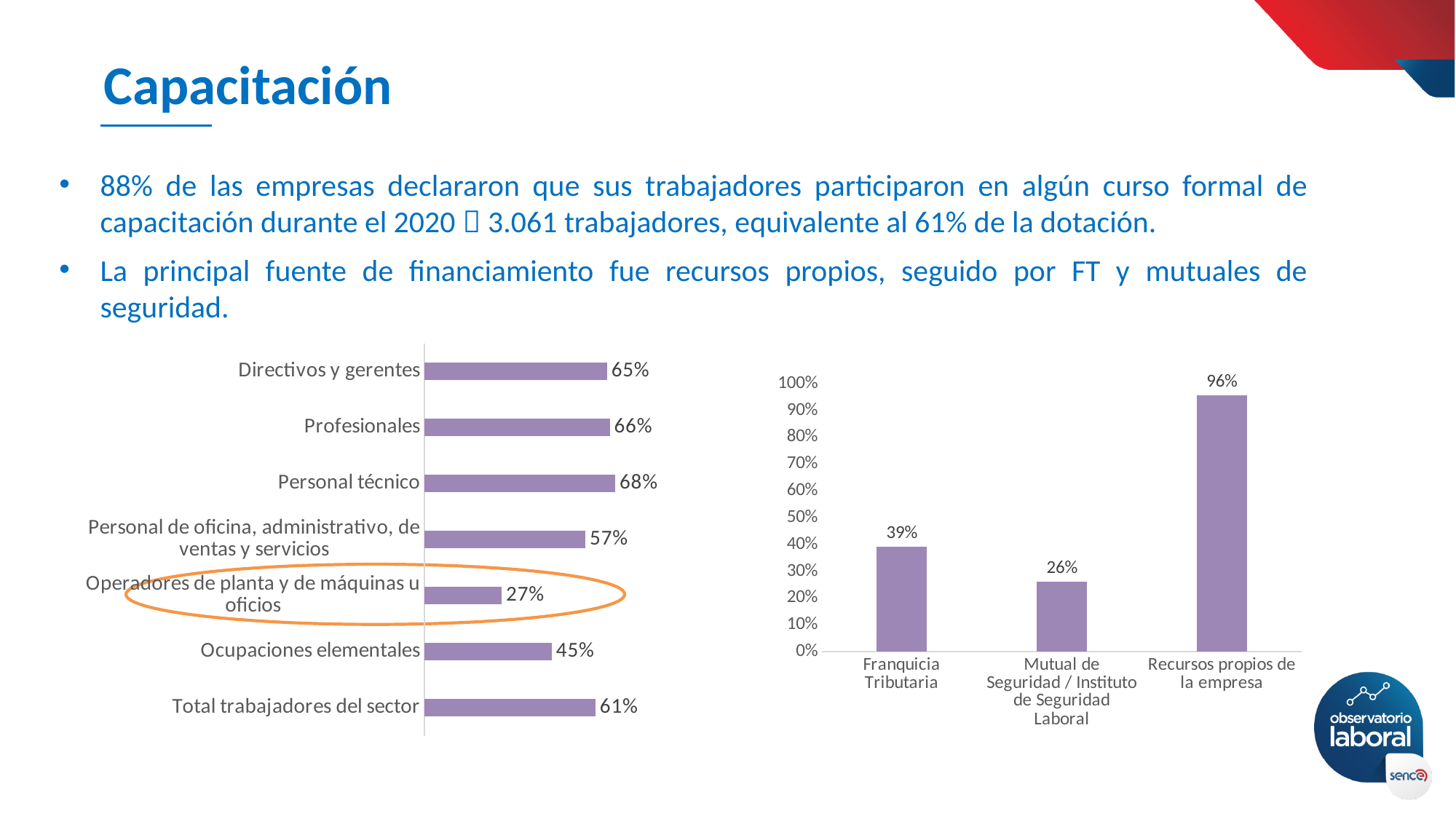
In the left chart, which category has the highest value? Personal técnico In the right chart, how many categories are shown? 3 In the left chart, what is the value for Personal técnico? 68% In the right chart, what is the value for Recursos propios de la empresa? 96% In the left chart, which category has the lowest value? Operadores de planta y de máquinas u oficios In the left chart, how many categories are shown? 7 In the right chart, which category has the lowest value? Mutual de Seguridad / Instituto de Seguridad Laboral In the right chart, what is the difference between Recursos propios de la empresa and Franquicia Tributaria? 57% In the left chart, what is the difference between Profesionales and Ocupaciones elementales? 21% What type of chart is the right chart? Bar chart In the left chart, what is the value for Operadores de planta y de máquinas u oficios? 27% In the left chart, what is the value for Total trabajadores del sector? 61%